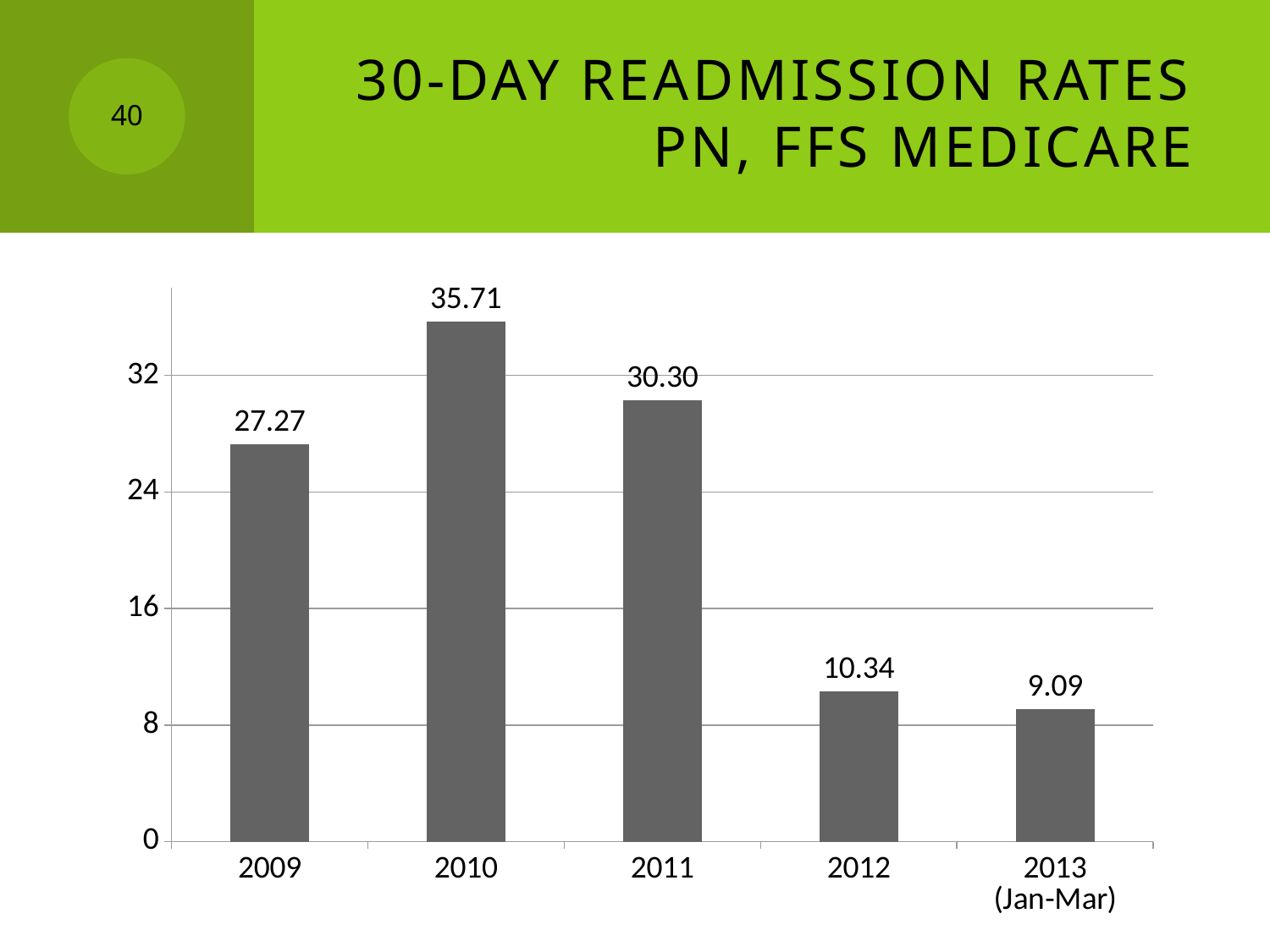
Do the readmission rates rise or fall from 2010 to 2013 (Jan-Mar)? fall What is the 30-day readmission rate for 2013 (Jan-Mar)? 9.09 What is the difference between the 2010 and 2011 readmission rates? 5.41 What is the difference between the 2009 and 2012 readmission rates? 16.93 Is the value for 2012 greater or less than 16? less What is the 30-day readmission rate for 2010? 35.71 Which is larger, the readmission rate for 2009 or for 2011? 2011 Which category has the lowest 30-day readmission rate? 2013 (Jan-Mar) What is the value shown for 2012? 10.34 What kind of chart is shown on the slide? bar chart Which year has the highest 30-day readmission rate? 2010 How many categories are shown on the x axis? 5